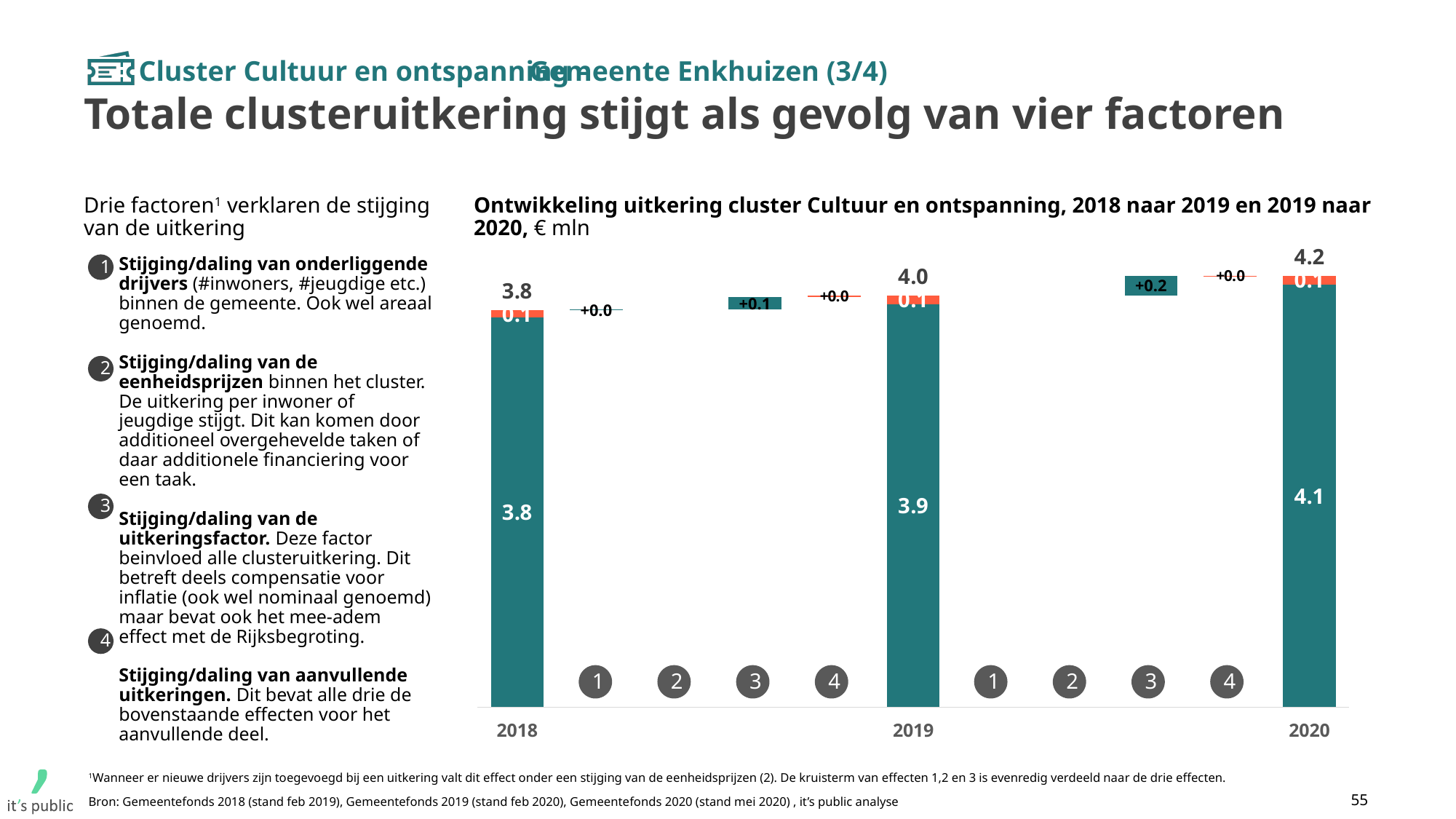
What is the total uitkering shown above the 2019 bar? 4.0 What is the value of effect 3 (uitkeringsfactor) in the step from 2018 to 2019? +0.1 What is the value of effect 3 (uitkeringsfactor) in the step from 2019 to 2020? +0.2 Which year has the lowest total uitkering? 2018 Which year has the highest total uitkering? 2020 What is the total uitkering shown above the 2020 bar? 4.2 Is the effect 3 step larger from 2018 to 2019 or from 2019 to 2020? 2019 to 2020 What value is printed in the large teal segment of the 2020 bar? 4.1 What value is printed in the large teal segment of the 2019 bar? 3.9 In what unit are the values in the chart expressed? € mln By how much does the total uitkering in 2020 exceed that of 2018? 0.4 What is the total uitkering shown above the 2018 bar? 3.8